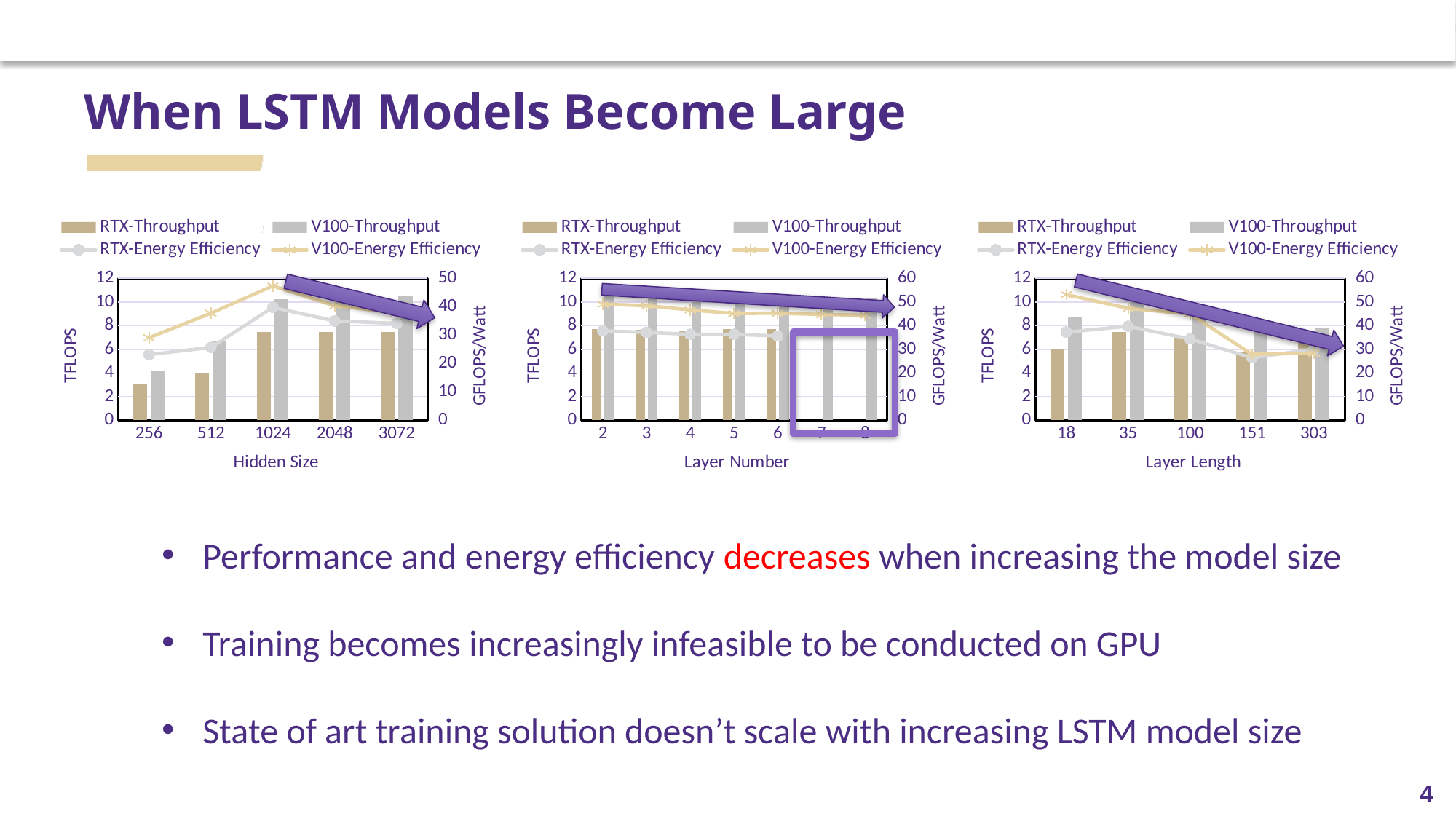
In the Hidden Size chart (left), is the V100-Throughput value at hidden size 1024 greater or less than 8 TFLOPS? greater In the Layer Number chart (middle), does V100-Energy Efficiency rise or fall as the layer number increases from 2 to 8? fall In the Layer Length chart (right), at which layer length is V100-Energy Efficiency highest? 18 In the Layer Number chart (middle), how many series does the legend list? 4 In the Hidden Size chart (left), how many hidden size categories are shown on the x axis? 5 In the Hidden Size chart (left), is the RTX-Throughput value at hidden size 256 greater or less than 4 TFLOPS? less What is the x-axis title of the left chart? Hidden Size In the Layer Length chart (right), is the V100-Energy Efficiency value at layer length 18 greater or less than 40 GFLOPS/Watt? greater In the Layer Number chart (middle), how many layer number categories are shown on the x axis? 7 In the Hidden Size chart (left), at hidden size 256, which is larger: RTX-Throughput or V100-Throughput? V100-Throughput In the Hidden Size chart (left), at which hidden size is RTX-Throughput lowest? 256